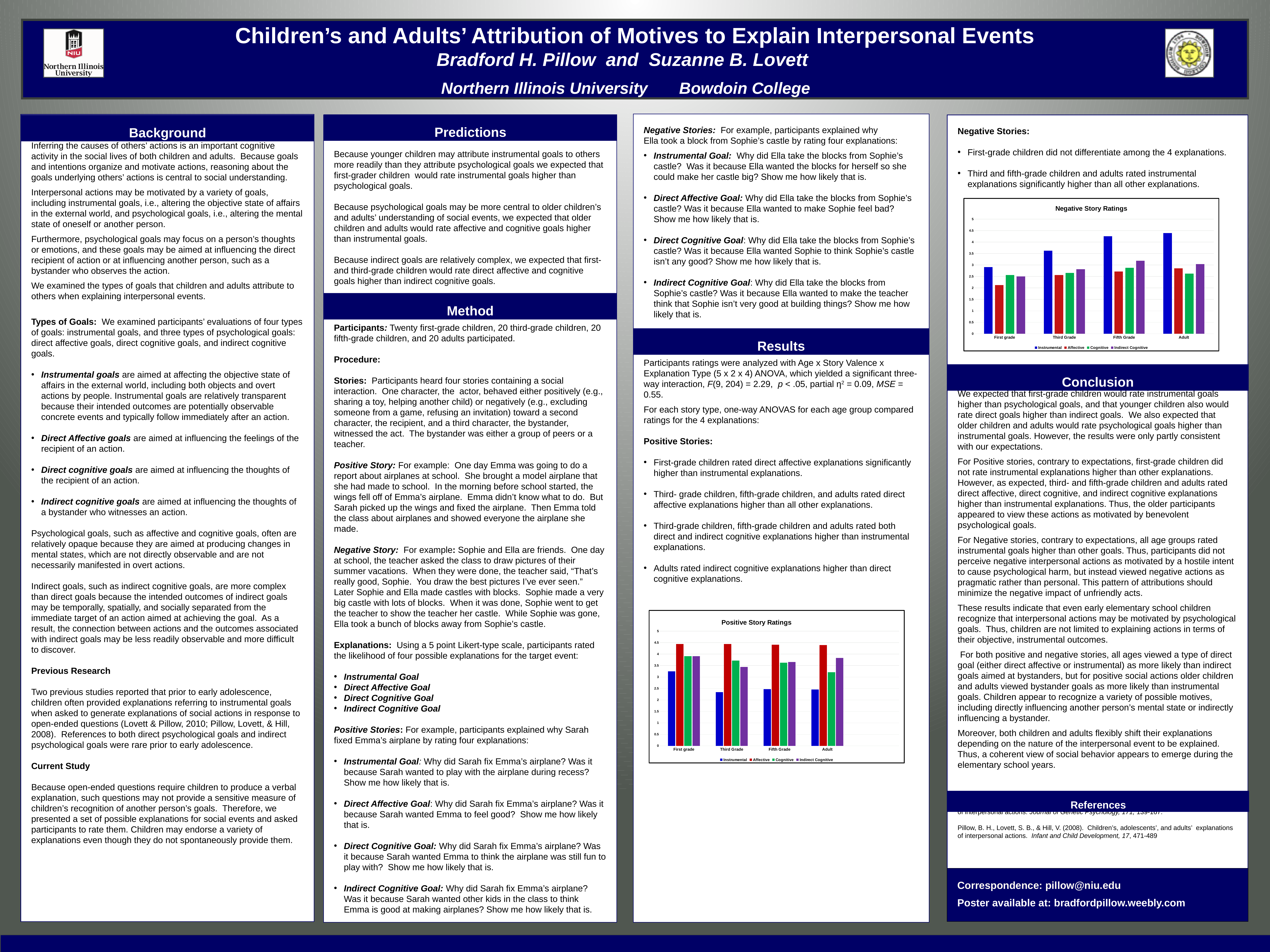
Which series is shown in red in the "Positive Story Ratings" chart? Affective In the "Negative Story Ratings" chart, does the Instrumental rating rise or fall from First grade to Adult? rise In the "Positive Story Ratings" chart, which is larger for the Adult group: the Affective rating or the Cognitive rating? Affective In the "Negative Story Ratings" chart, which explanation type has the lowest rating for the First grade group? Affective In the "Negative Story Ratings" chart, is the Affective rating for First grade greater or less than 2.5? less How many age-group categories are shown on the x axis of the "Positive Story Ratings" chart? 4 What kind of chart is the "Negative Story Ratings" chart? bar chart In the "Positive Story Ratings" chart, is the Instrumental rating for Third Grade greater or less than 2.5? less In the "Positive Story Ratings" chart, which explanation type has the lowest rating for the Third Grade group? Instrumental In the "Negative Story Ratings" chart, which explanation type has the highest rating for the Adult group? Instrumental How many series does the legend of the "Negative Story Ratings" chart list? 4 In the "Negative Story Ratings" chart, is the Instrumental rating for Fifth Grade greater or less than 4? greater